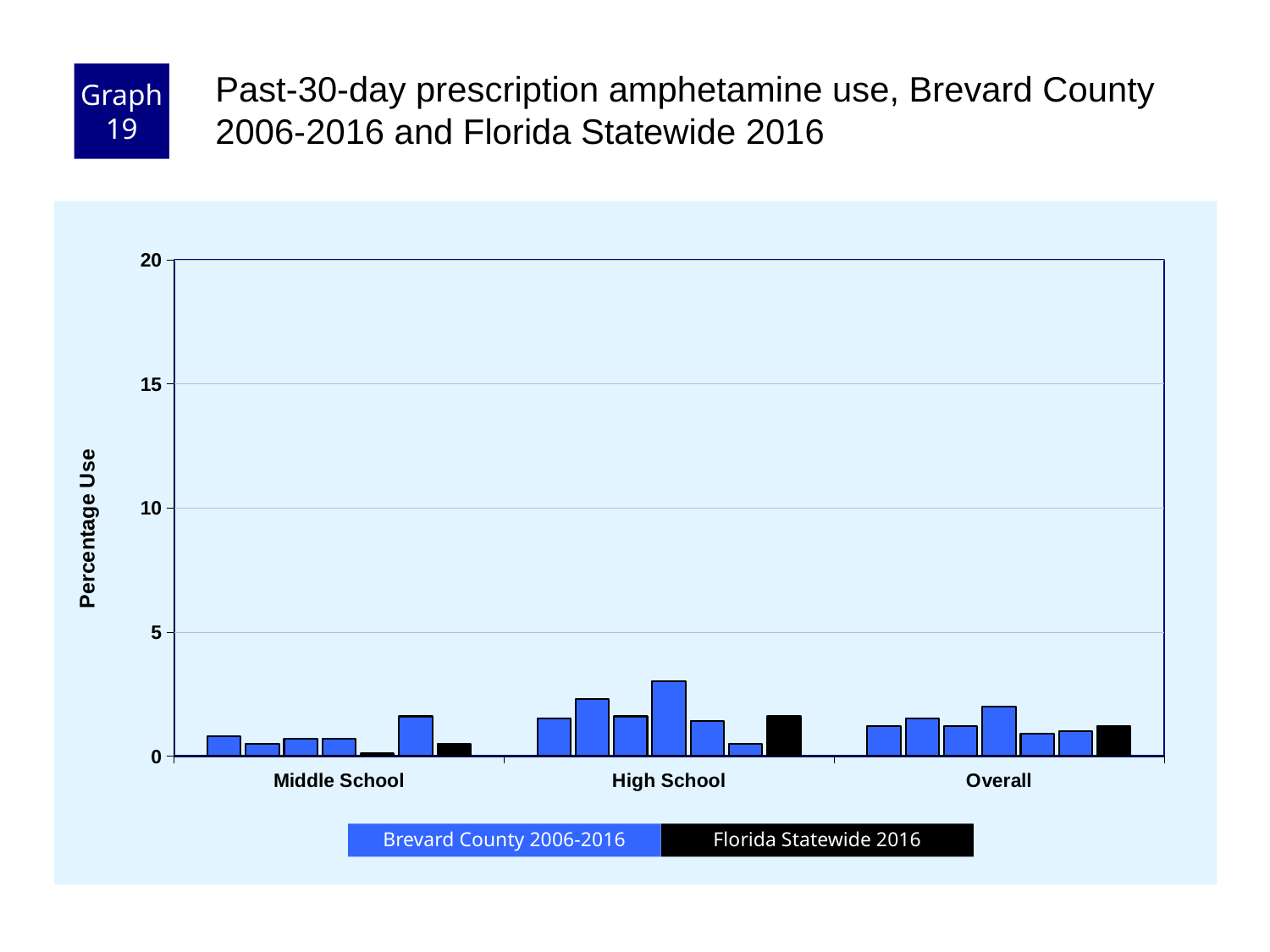
How many categories are shown on the x axis? 3 Which is larger: the Florida Statewide 2016 value for High School or for Middle School? High School What is the label on the y axis? Percentage Use Is the Florida Statewide 2016 value for High School greater or less than 5? less Is the Florida Statewide 2016 value for Overall greater or less than 5? less What kind of chart is shown on the slide? Bar chart Which is larger: the Florida Statewide 2016 value for Overall or for Middle School? Overall Which category group contains the tallest bar on the chart? High School How many series does the legend list? 2 Is the tallest Brevard County bar in the High School group greater or less than 5? less Which colour represents Florida Statewide 2016 in the legend? Black